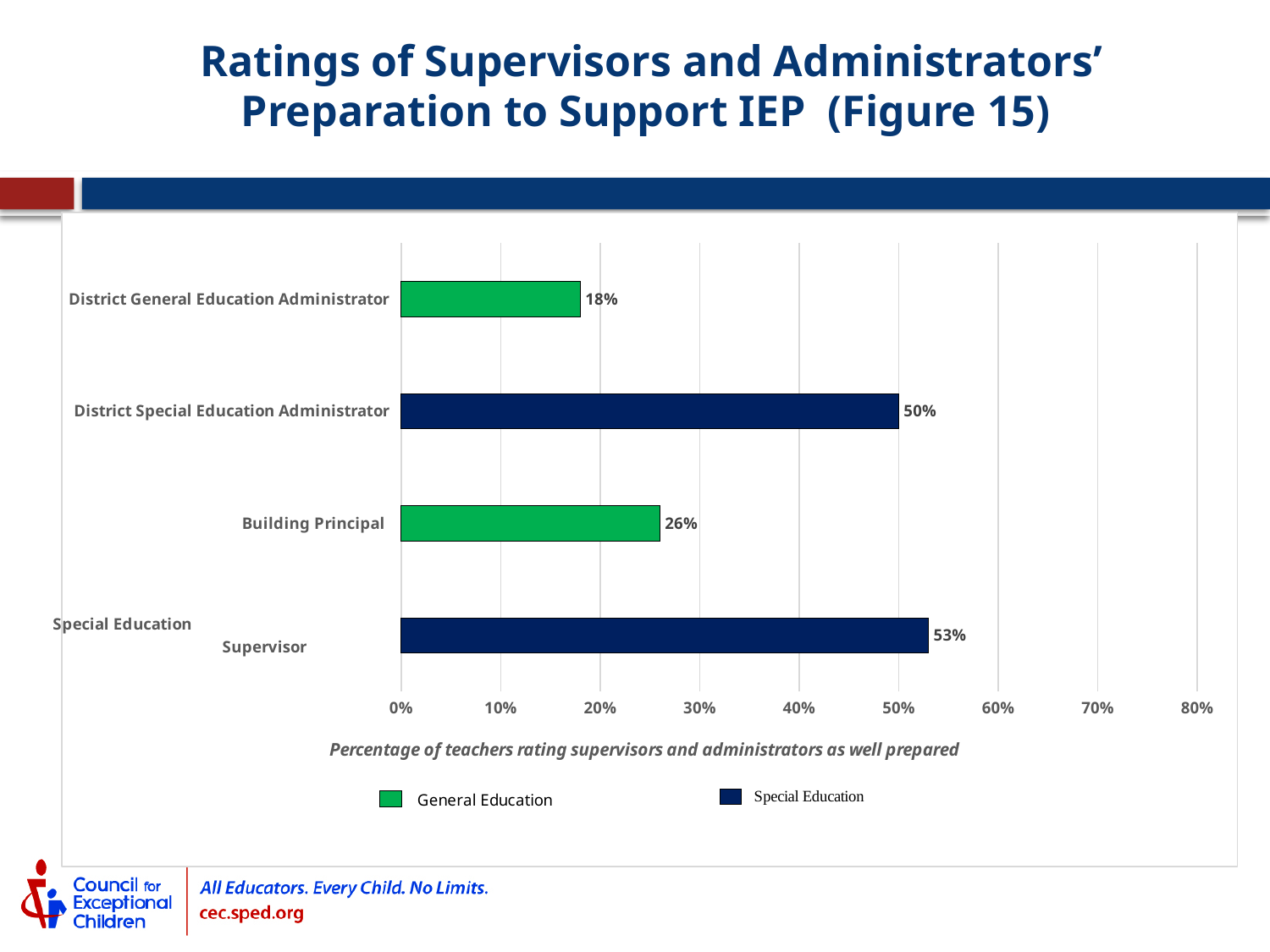
What is the difference between the values for Special Education Supervisor and District General Education Administrator? 35% How many categories are shown in the chart? 4 What is the value for District Special Education Administrator? 50% What is the value for Special Education Supervisor? 53% What is the value for District General Education Administrator? 18% What is the value for Building Principal? 26% What is the difference between the values for Building Principal and District General Education Administrator? 8% Which category has the lowest value? District General Education Administrator How many series does the legend list? 2 What kind of chart is shown on the slide? Bar chart Which category has the highest value? Special Education Supervisor Which is larger, the value for Building Principal or the value for District Special Education Administrator? District Special Education Administrator